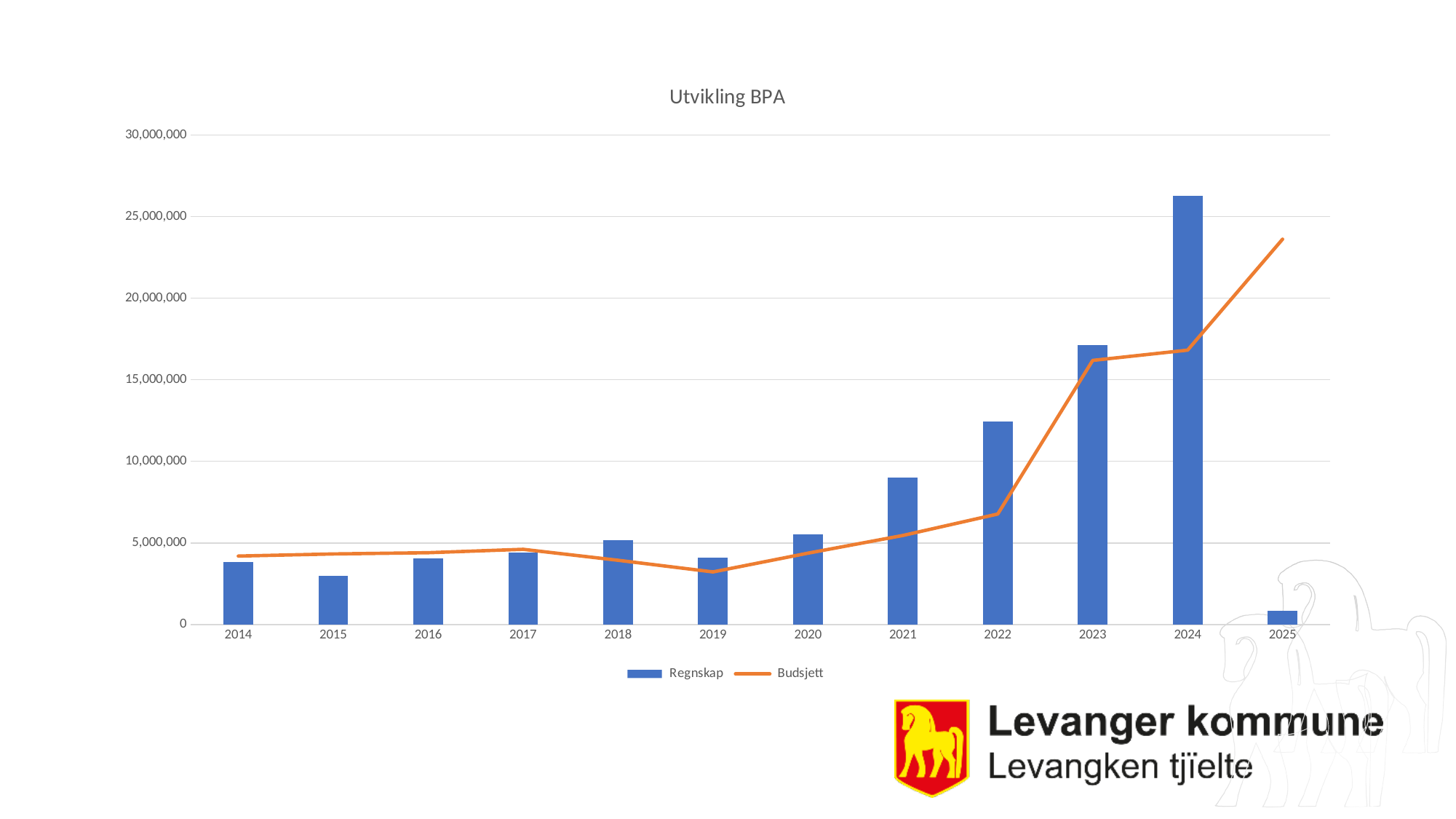
Is the Regnskap value for 2024 greater or less than 25,000,000? greater What is the title of the chart? Utvikling BPA In 2025, which is larger, Regnskap or Budsjett? Budsjett Which year has the lowest Regnskap bar? 2025 Do the Regnskap values rise or fall from 2020 to 2024? rise How many years are shown on the x axis? 12 What kind of chart is shown on the slide? A bar chart combined with a line Is the Budsjett value for 2025 greater or less than 20,000,000? greater How many series does the legend list? 2 Which year has the highest Regnskap bar? 2024 Is the Regnskap value for 2015 greater or less than 5,000,000? less In 2024, which is larger, Regnskap or Budsjett? Regnskap